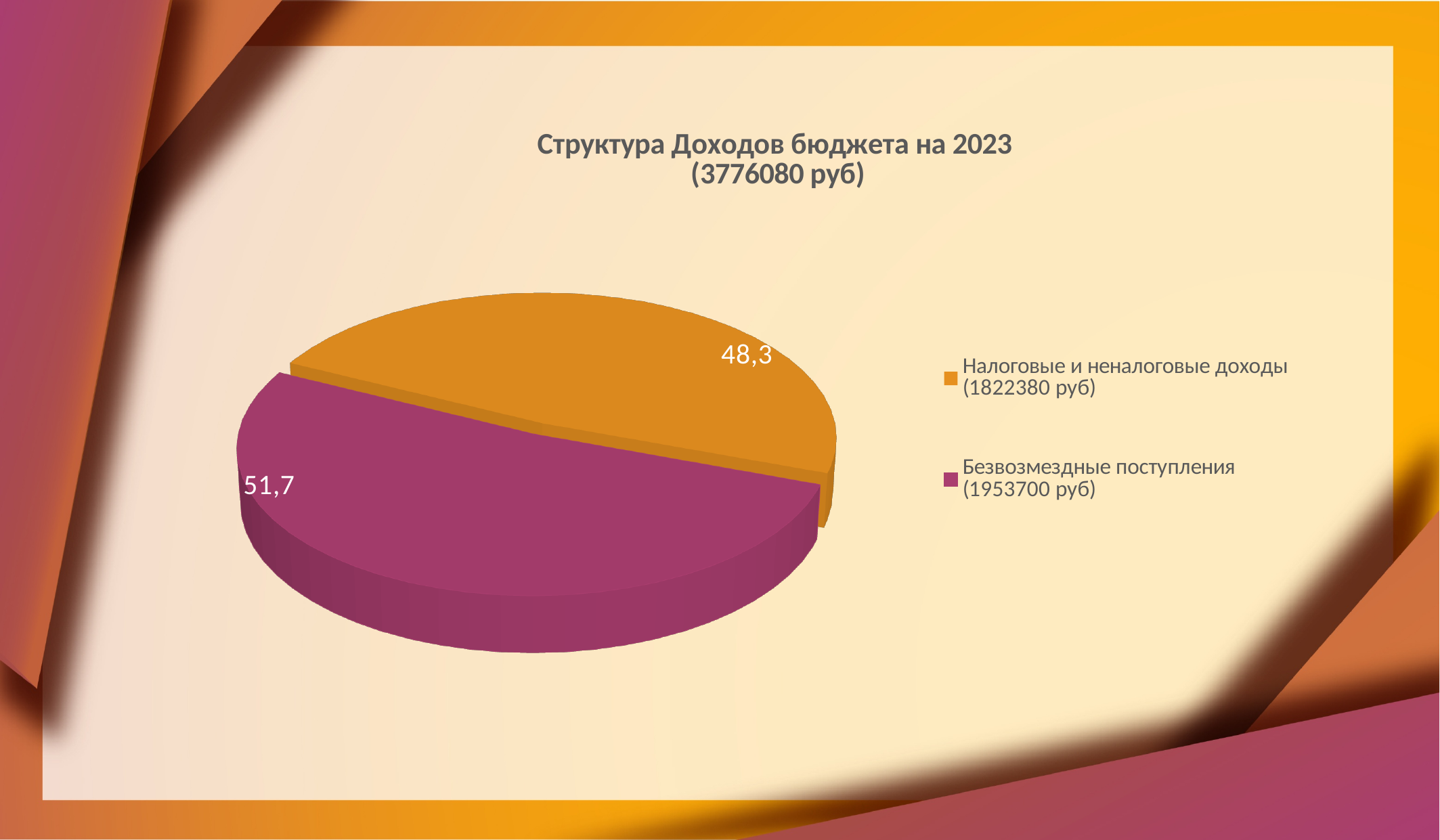
How many slices does the pie chart have? 2 What is the title of the chart? Структура Доходов бюджета на 2023 (3776080 руб) Which category has the largest slice of the pie? Безвозмездные поступления What is the difference between the labelled values for Безвозмездные поступления and Налоговые и неналоговые доходы? 3,4 What value is labelled on the slice for Налоговые и неналоговые доходы? 48,3 Which category has the smallest slice of the pie? Налоговые и неналоговые доходы What amount in rubles does the legend give for Налоговые и неналоговые доходы? 1822380 руб What amount in rubles does the legend give for Безвозмездные поступления? 1953700 руб What colour is the slice for Безвозмездные поступления? purple What kind of chart is shown on the slide? pie chart Which is larger: the slice for Налоговые и неналоговые доходы or the slice for Безвозмездные поступления? Безвозмездные поступления What value is labelled on the slice for Безвозмездные поступления? 51,7